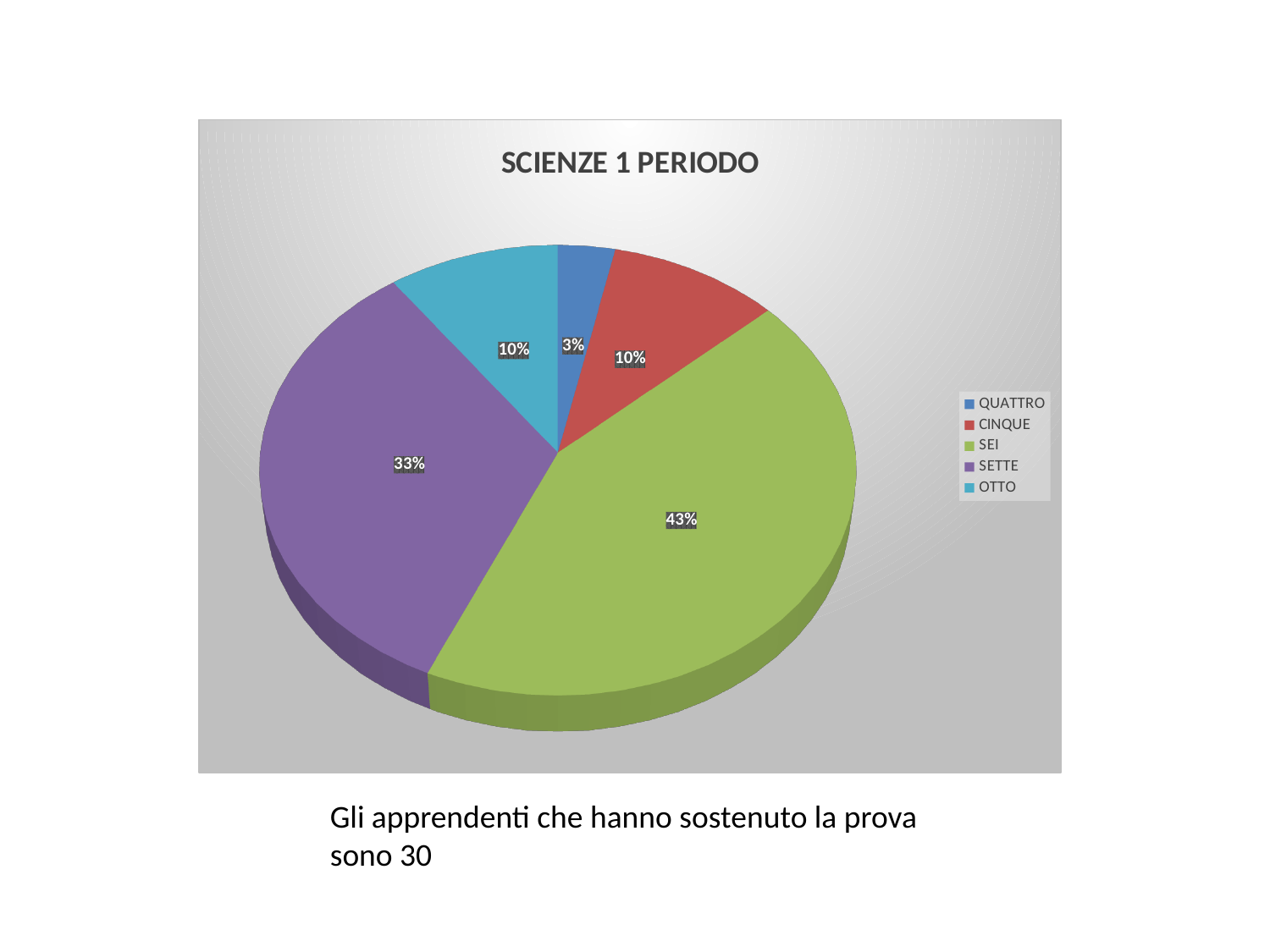
What is the difference in percentage points between the SEI slice and the SETTE slice? 10 percentage points Which category has the smallest slice of the pie? QUATTRO How many categories does the legend list? 5 What is the value shown for CINQUE? 10% Which is larger, the slice for SETTE or the slice for CINQUE? SETTE What share of the pie does the SETTE slice represent? 33% What is the value shown for QUATTRO? 3% What is the value shown for OTTO? 10% Which category has the largest slice of the pie? SEI What is the title of the chart? SCIENZE 1 PERIODO What kind of chart is shown on the slide? pie chart What share of the pie does the SEI slice represent? 43%